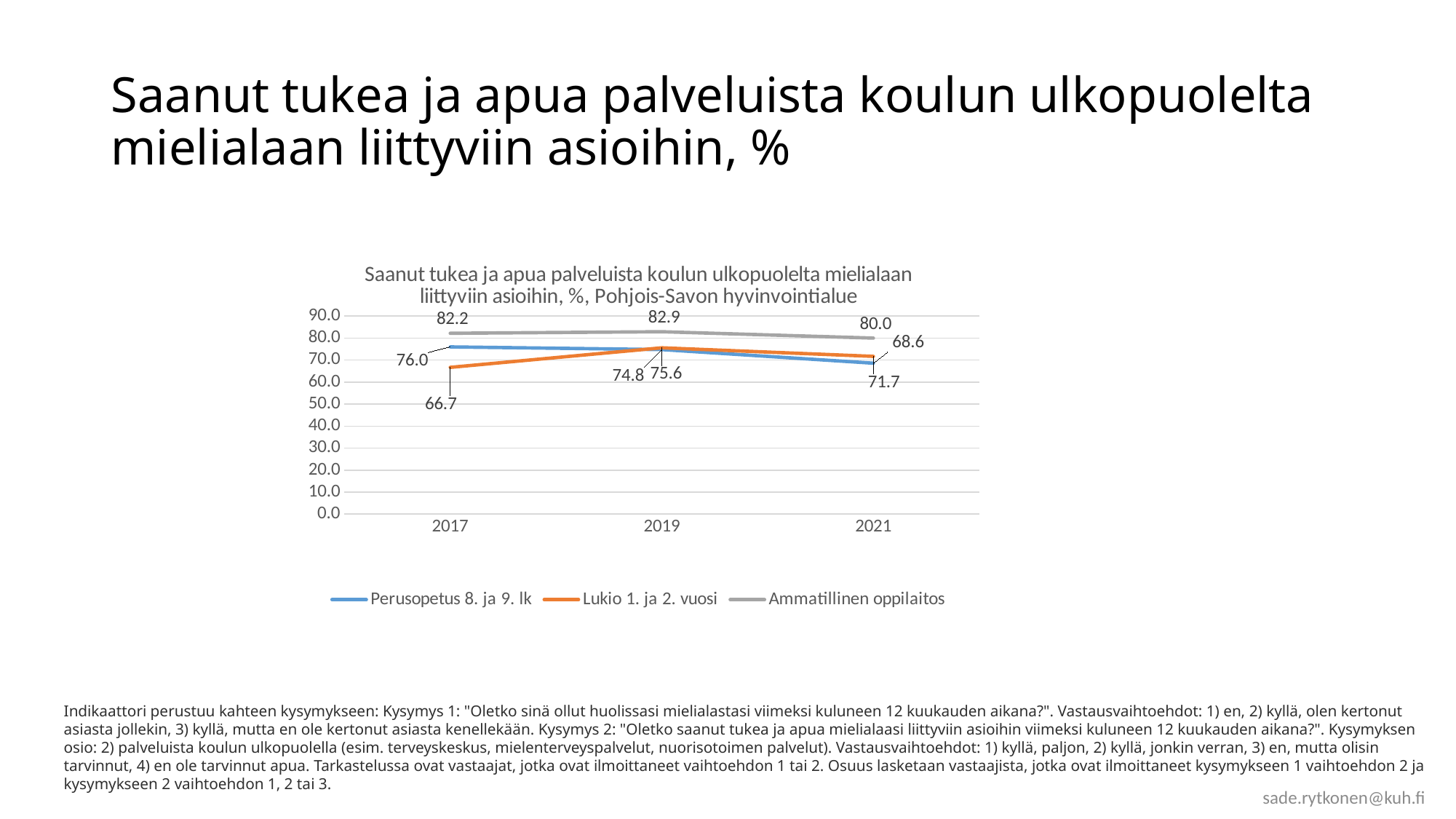
What is the value for Lukio 1. ja 2. vuosi in 2017? 66.7 What type of chart is shown on the slide? line chart What is the value for Perusopetus 8. ja 9. lk in 2017? 76.0 Is the value for Lukio 1. ja 2. vuosi in 2017 greater or less than 70.0? less Which region is named in the chart title? Pohjois-Savon hyvinvointialue What is the difference between the Ammatillinen oppilaitos values in 2017 and 2021? 2.2 How many years are shown on the x axis? 3 How many series does the legend list? 3 Which series has the lowest value in 2017? Lukio 1. ja 2. vuosi What is the value for Ammatillinen oppilaitos in 2021? 80.0 Which series has the highest value in 2017? Ammatillinen oppilaitos What is the value for Ammatillinen oppilaitos in 2019? 82.9